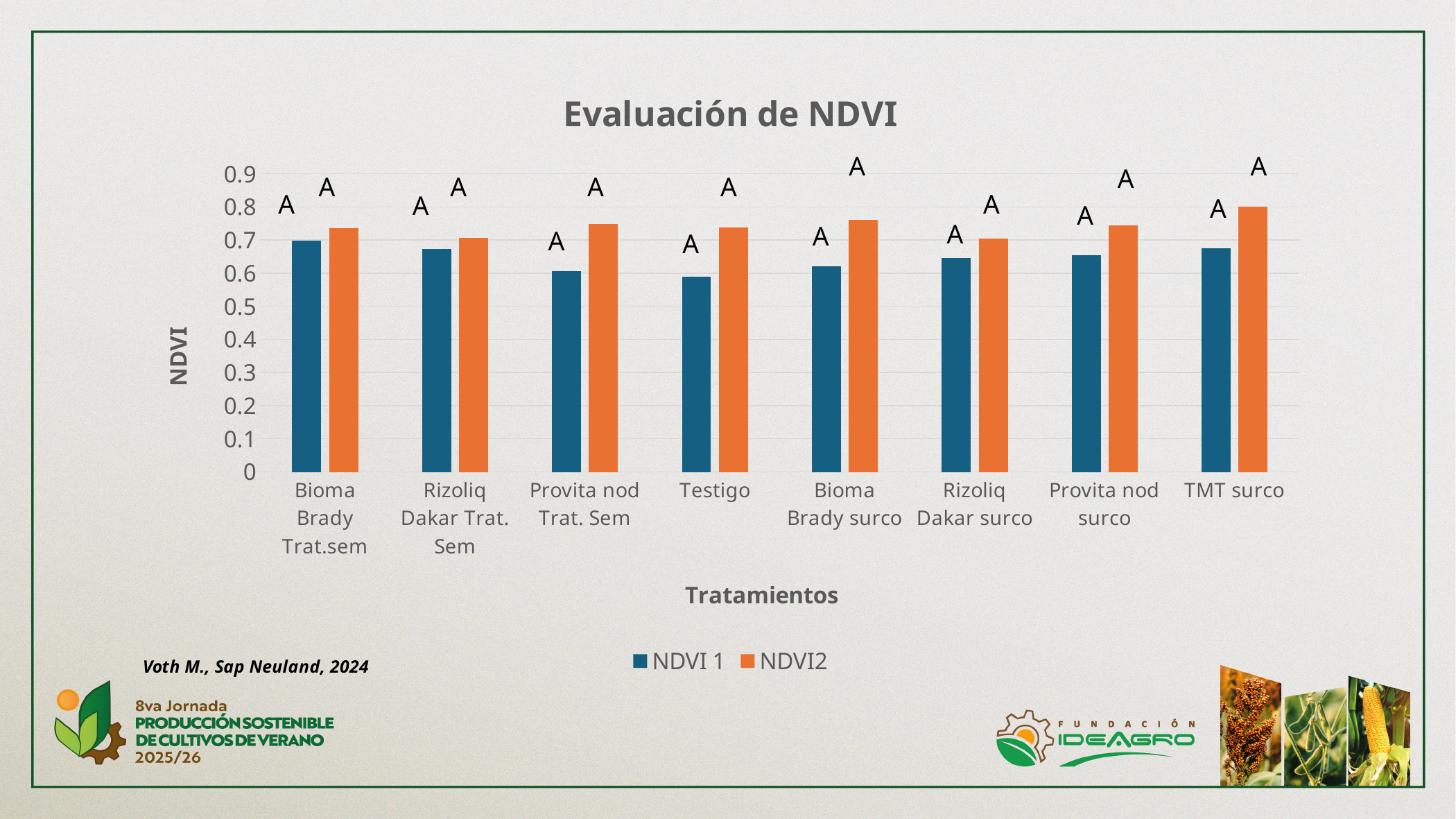
For Testigo, which series has the larger value, NDVI 1 or NDVI2? NDVI2 Is the NDVI2 value for Testigo greater or less than 0.7? greater Is the NDVI 1 value for Rizoliq Dakar surco greater or less than 0.7? less Is the NDVI2 value for TMT surco greater or less than 0.7? greater Which is larger: the NDVI 1 value for Bioma Brady Trat.sem or the NDVI 1 value for Testigo? Bioma Brady Trat.sem What kind of chart is shown on the slide? bar chart Which treatment has the highest NDVI2 value? TMT surco What is the title of the chart? Evaluación de NDVI Which treatment has the highest NDVI 1 value? Bioma Brady Trat.sem What is the label of the x axis? Tratamientos How many series does the legend list? 2 How many treatments (categories) are shown on the x axis? 8